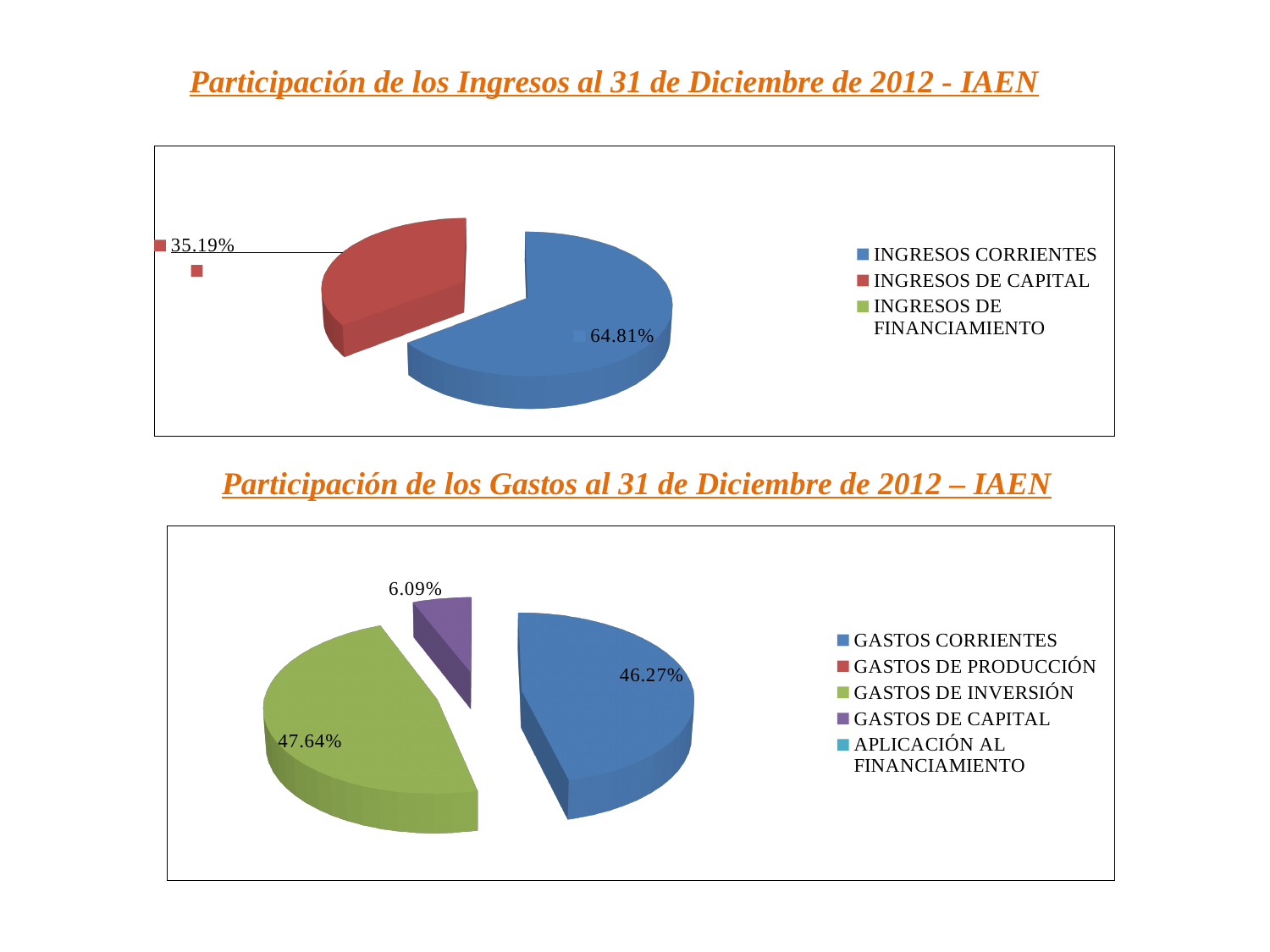
In the top chart (Participación de los Ingresos), how many entries does the legend list? 3 In the top chart (Participación de los Ingresos), what is the difference between the shares of INGRESOS CORRIENTES and INGRESOS DE CAPITAL? 29.62 percentage points In the bottom chart (Participación de los Gastos), what is the difference between the shares of GASTOS DE INVERSIÓN and GASTOS DE CAPITAL? 41.55 percentage points In the bottom chart (Participación de los Gastos), how many entries does the legend list? 5 In the bottom chart (Participación de los Gastos), what share is shown for GASTOS DE INVERSIÓN? 47.64% In the bottom chart (Participación de los Gastos), which is larger: GASTOS CORRIENTES or GASTOS DE INVERSIÓN? GASTOS DE INVERSIÓN In the top chart (Participación de los Ingresos), which category has the largest slice? INGRESOS CORRIENTES In the bottom chart (Participación de los Gastos), what share is shown for GASTOS DE CAPITAL? 6.09% In the top chart (Participación de los Ingresos), what share is shown for INGRESOS DE CAPITAL? 35.19% In the top chart (Participación de los Ingresos), what share is shown for INGRESOS CORRIENTES? 64.81% In the bottom chart (Participación de los Gastos), what share is shown for GASTOS CORRIENTES? 46.27% What kind of chart is the top chart (Participación de los Ingresos)? Pie chart